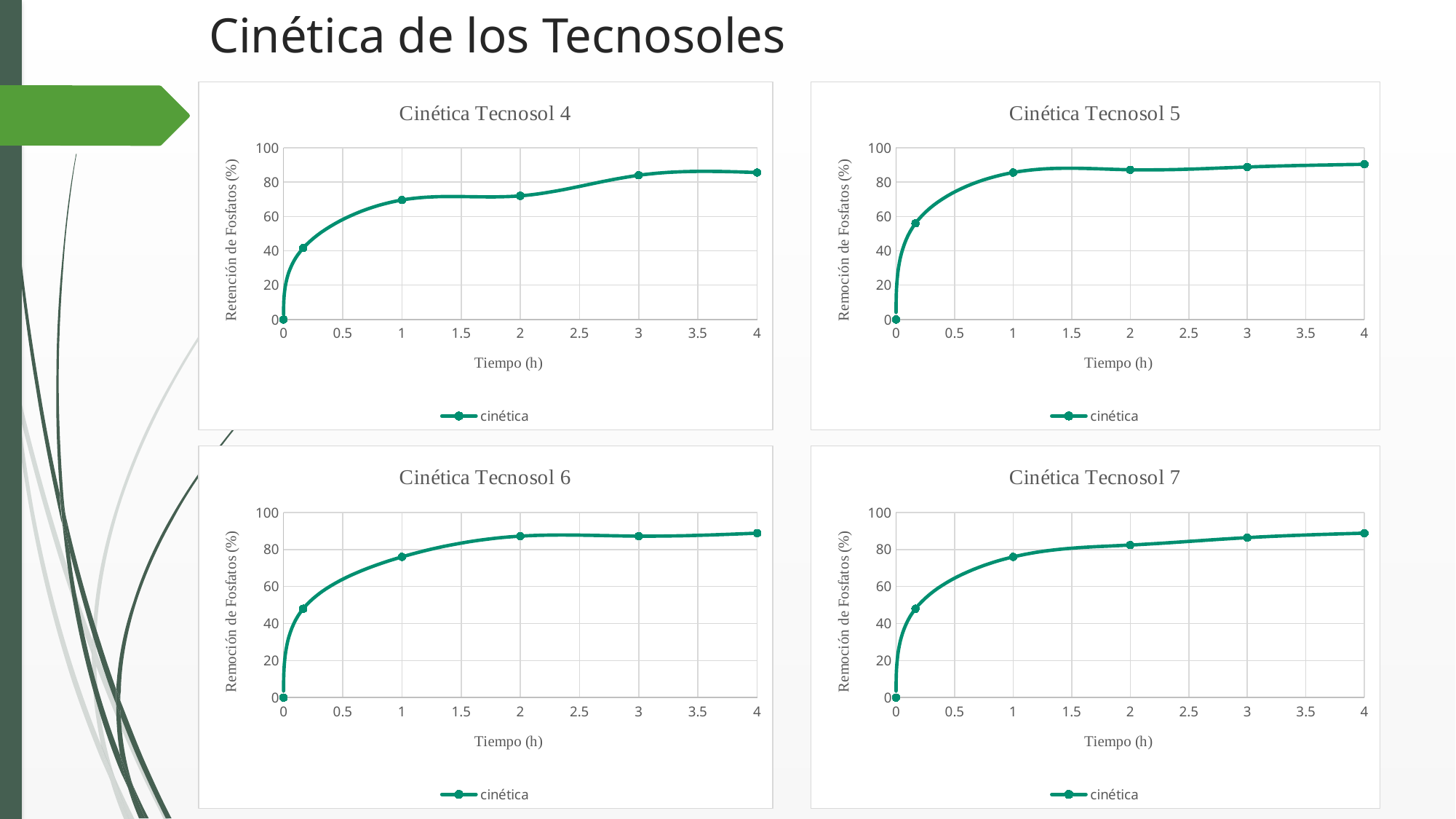
In the "Cinética Tecnosol 6" chart, is the value at 1 h greater or less than 60? greater In the "Cinética Tecnosol 4" chart, which is larger: the value at 2 h or the value at 3 h? 3 h What kind of chart is "Cinética Tecnosol 4"? line chart In the "Cinética Tecnosol 4" chart, is the value at 1 h greater or less than 60? greater In the "Cinética Tecnosol 7" chart, do the values rise or fall as time increases? rise In the "Cinética Tecnosol 7" chart, is the value at 4 h greater or less than 80? greater In the "Cinética Tecnosol 7" chart, at which time is the value lowest? 0 How many series does the legend of the "Cinética Tecnosol 6" chart list? 1 What is the y-axis title of the "Cinética Tecnosol 4" chart? Retención de Fosfatos (%) In the "Cinética Tecnosol 5" chart, how many data points are plotted? 6